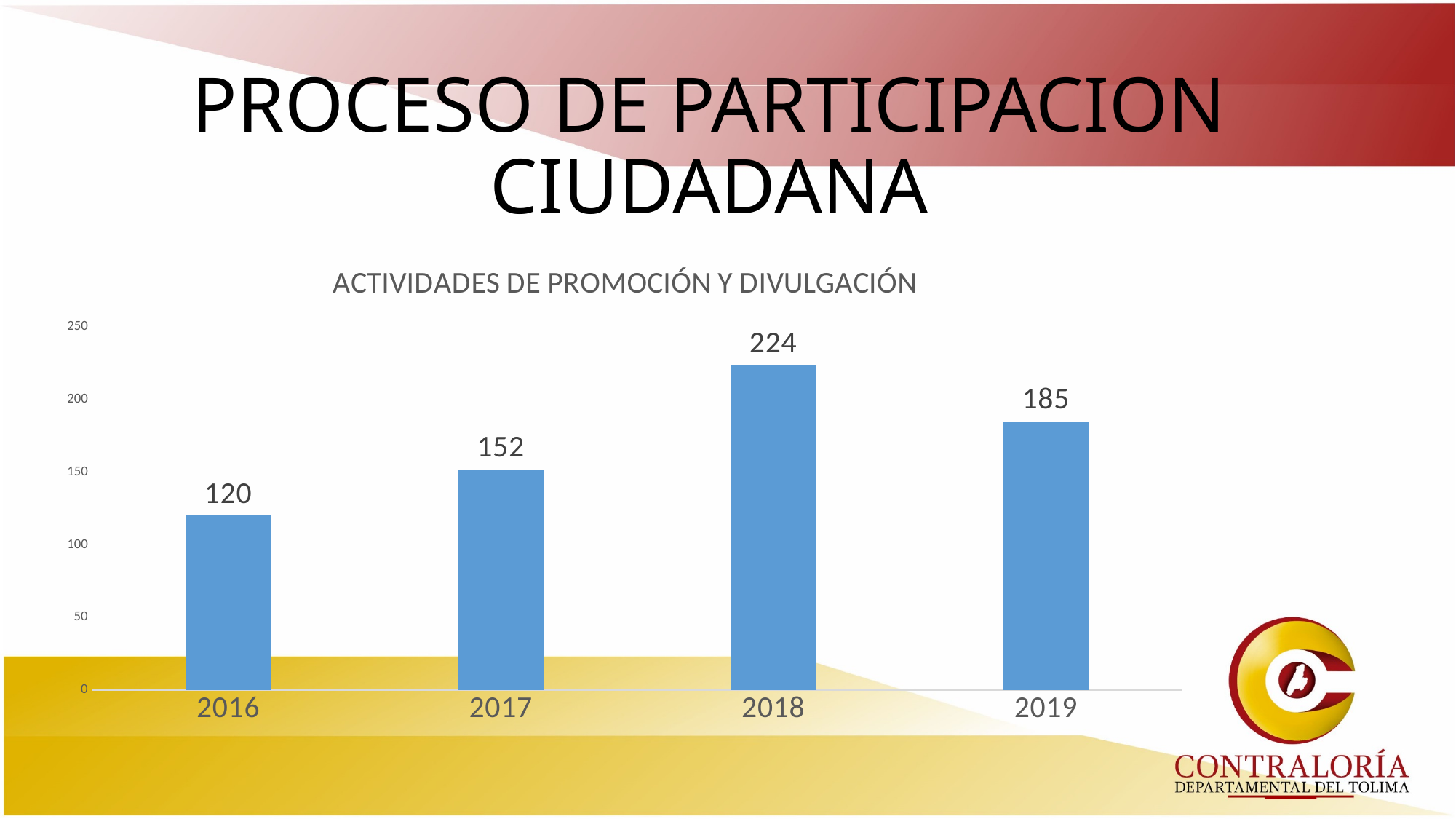
What is the value for 2019? 185 Which year has the highest value? 2018 What is the difference between the values for 2019 and 2016? 65 What is the value for 2018? 224 Is the value for 2017 greater or less than 200? less What is the title of the chart? ACTIVIDADES DE PROMOCIÓN Y DIVULGACIÓN What is the difference between the values for 2018 and 2017? 72 How many years are shown on the x axis? 4 Which is larger, the value for 2017 or the value for 2019? 2019 What is the value for 2016? 120 What kind of chart is shown on the slide? bar chart Which year has the lowest value? 2016